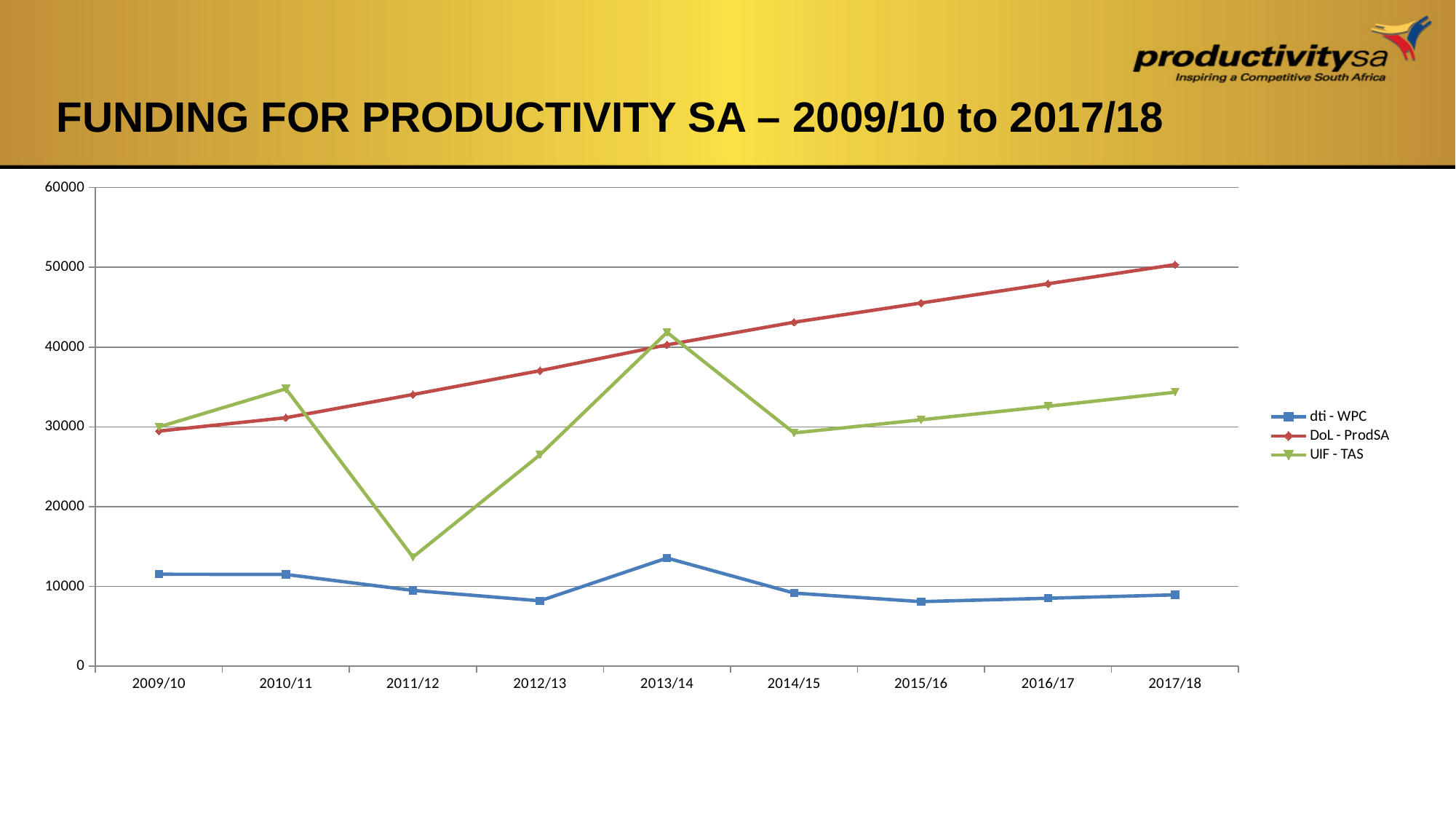
How many series does the legend list? 3 Is the value for DoL - ProdSA in 2017/18 greater or less than 40000? greater Is the value for UIF - TAS in 2011/12 greater or less than 20000? less In which year is the dti - WPC series at its highest? 2013/14 Is the value for dti - WPC in 2013/14 greater or less than 10000? greater What kind of chart is shown on the slide? line chart Does the DoL - ProdSA series rise or fall from 2009/10 to 2017/18? rise In which year is the DoL - ProdSA series at its highest? 2017/18 In 2010/11, which series has the larger value: UIF - TAS or DoL - ProdSA? UIF - TAS In which year is the UIF - TAS series at its lowest? 2011/12 How many financial years are plotted along the x axis? 9 Which series is drawn in green? UIF - TAS